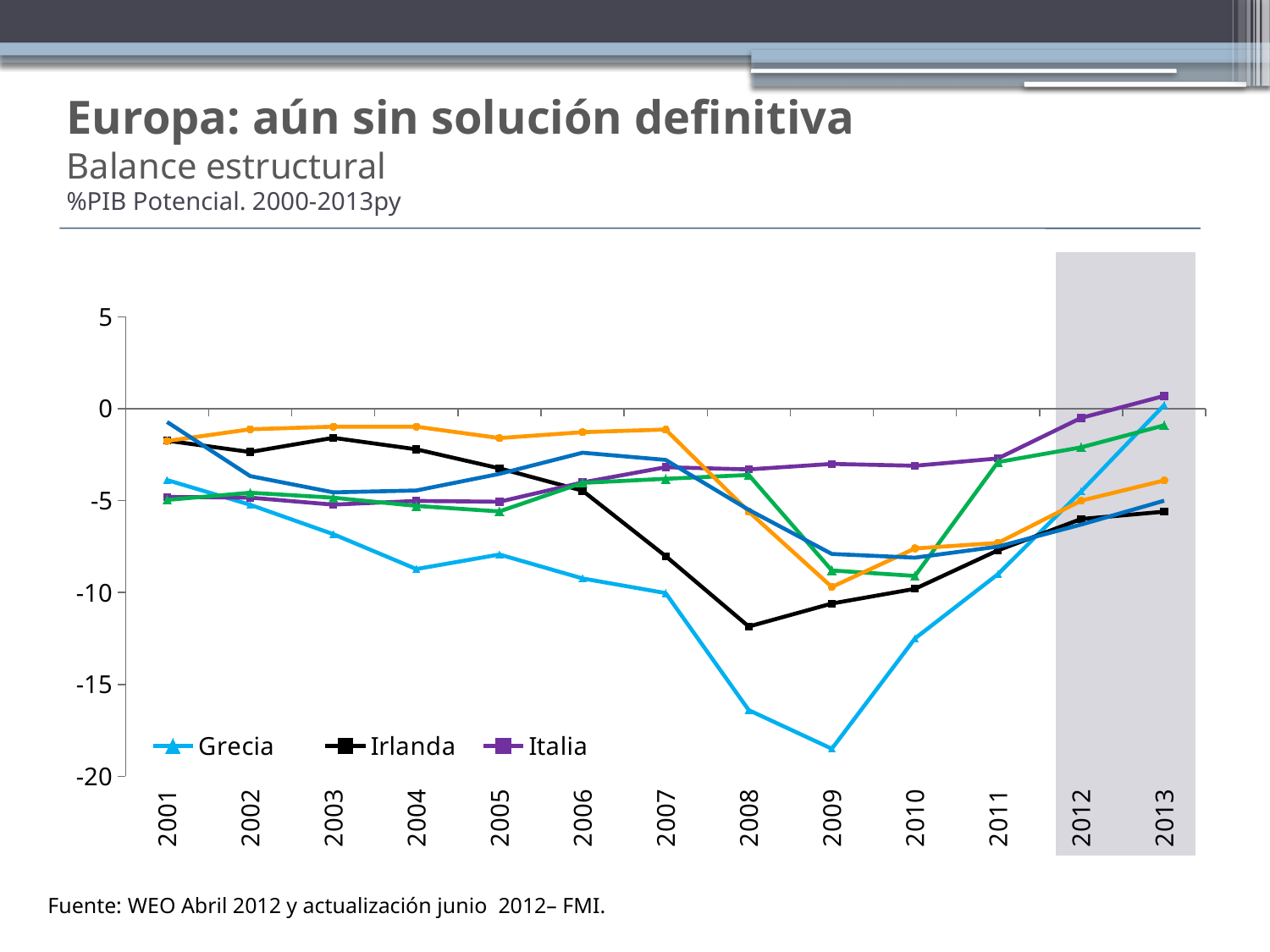
In which year does Grecia reach its lowest value? 2009 Does the Grecia line rise or fall from 2009 to 2013? Rises What kind of chart is shown on the slide? Line chart How many series does the legend list? 3 In which year does Irlanda reach its lowest value? 2008 Is the value for Italia in 2013 greater or less than 0? greater Is the value for Grecia in 2009 greater or less than -15? less Is the value for Grecia in 2001 greater or less than -5? greater How many years are shown on the x axis? 13 Which years on the x axis are highlighted with a grey shaded background? 2012 and 2013 Which is larger in 2009, the value for Grecia or the value for Irlanda? Irlanda